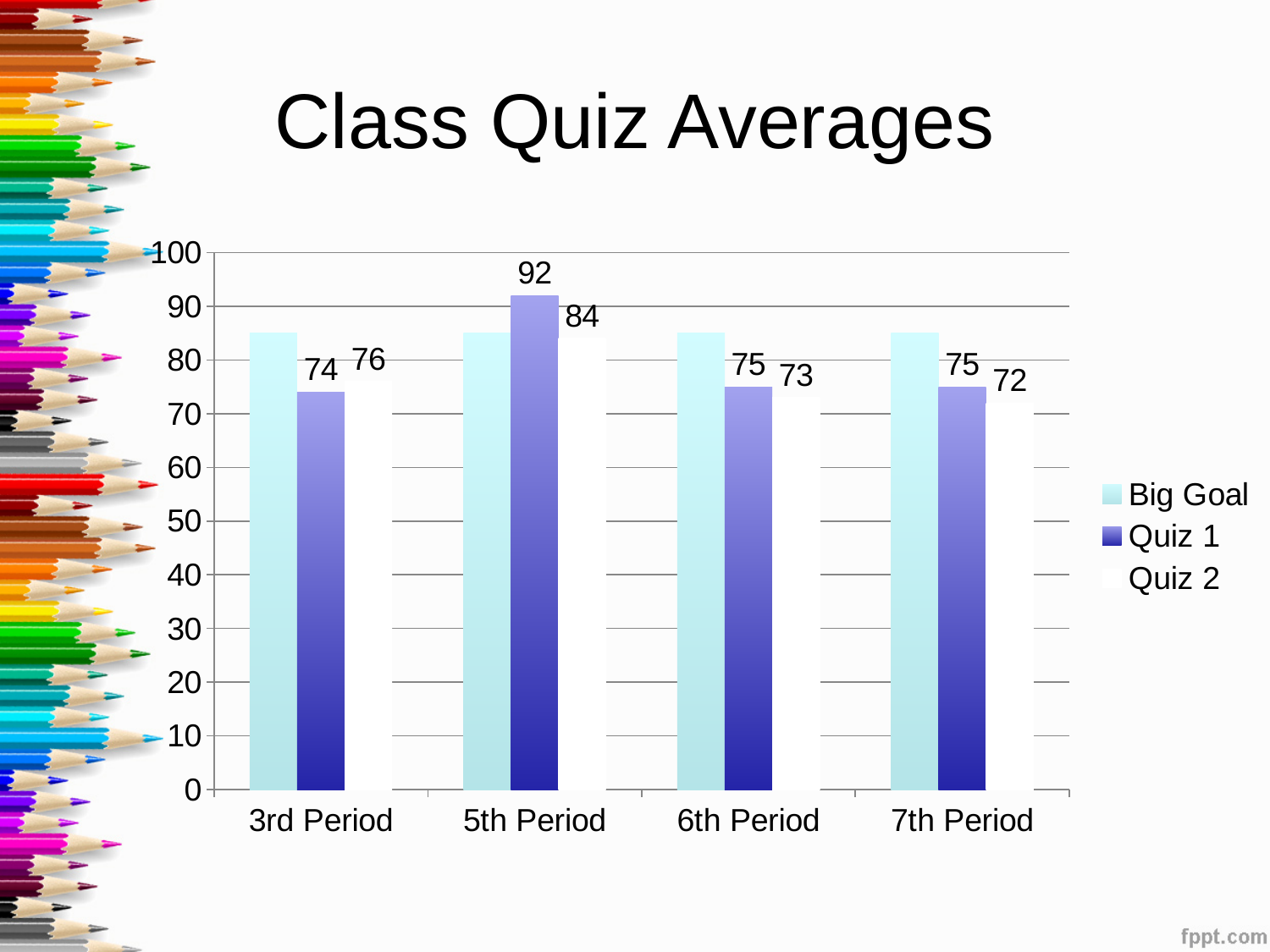
How many periods are shown on the x axis? 4 What is the difference between the Quiz 1 and Quiz 2 values for 5th Period? 8 What kind of chart is shown on the slide? bar chart Is the Big Goal value for 3rd Period greater or less than 80? greater What is the Quiz 2 value for 7th Period? 72 Which is larger for 6th Period, Quiz 1 or Quiz 2? Quiz 1 Which period has the lowest Quiz 2 value? 7th Period Which period has the highest Quiz 1 value? 5th Period How many series does the legend list? 3 What is the Quiz 2 value for 3rd Period? 76 What is the title of the chart? Class Quiz Averages What is the Quiz 1 value for 5th Period? 92